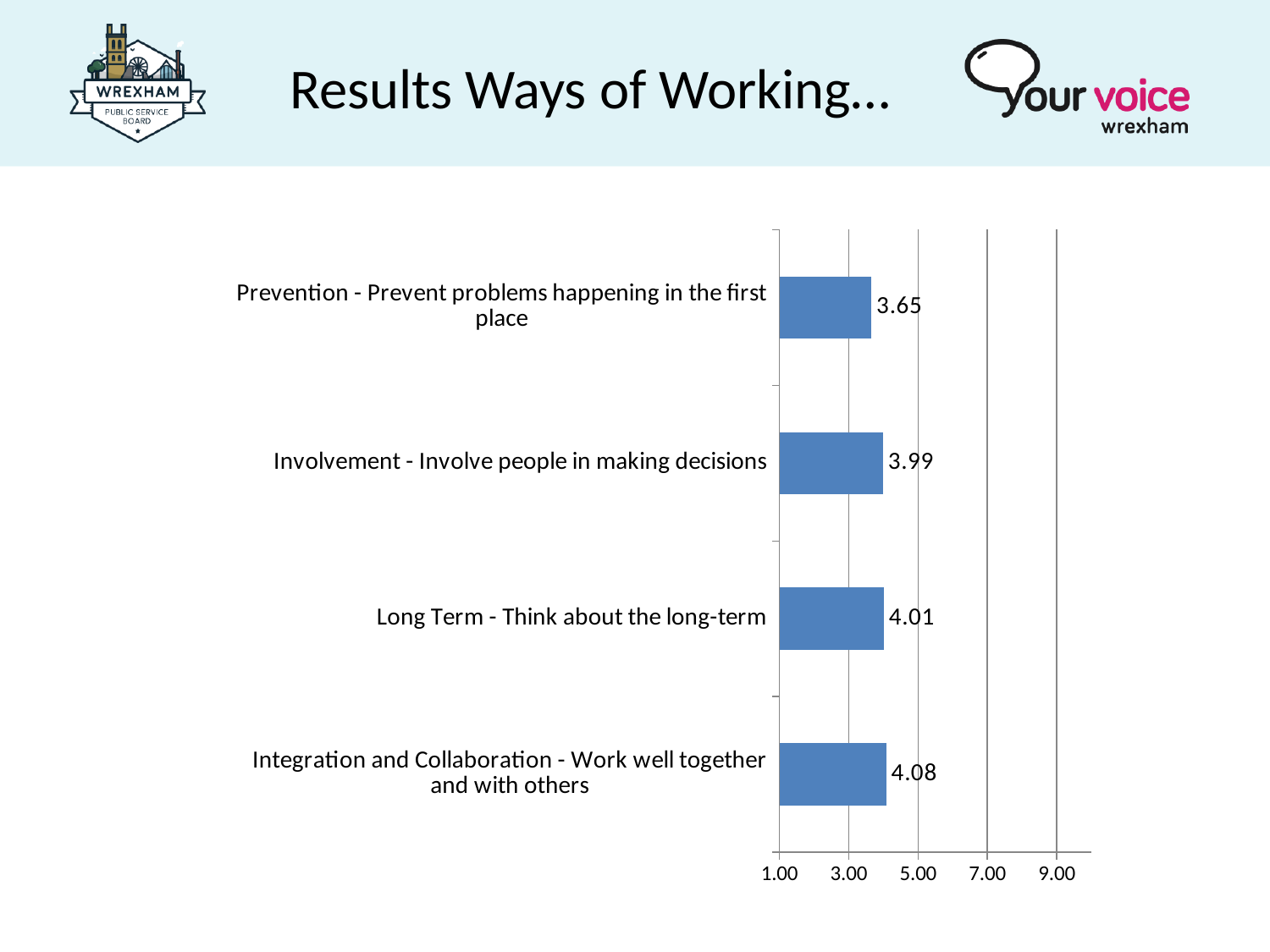
Which has a larger value, Involvement or Prevention? Involvement Which category has the lowest value? Prevention - Prevent problems happening in the first place What is the difference between the values for Long Term and Involvement? 0.02 What is the value for Integration and Collaboration - Work well together and with others? 4.08 How many categories are shown in the chart? 4 Is the value for Prevention greater or less than 5.00? less What is the value for Long Term - Think about the long-term? 4.01 Which category has the highest value? Integration and Collaboration - Work well together and with others What kind of chart is shown on the slide? Bar chart What is the value for Involvement - Involve people in making decisions? 3.99 What is the value for Prevention - Prevent problems happening in the first place? 3.65 What is the difference between the values for Integration and Collaboration and Prevention? 0.43